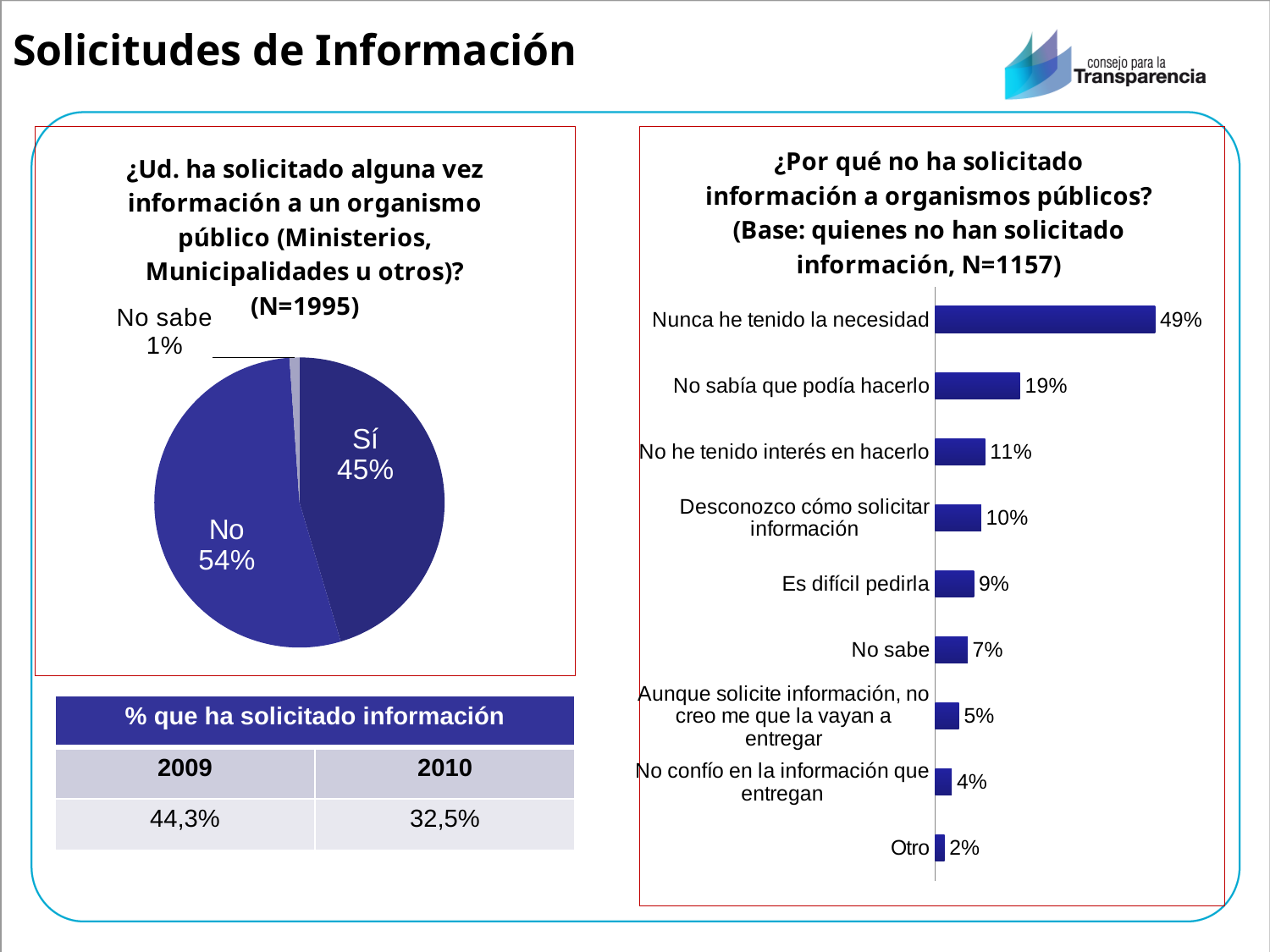
In the pie chart on the left, how many slices are there? 3 In the bar chart on the right, what is the difference between "Nunca he tenido la necesidad" and "No sabía que podía hacerlo"? 30% In the bar chart on the right, what is the value for "Es difícil pedirla"? 9% What kind of chart is the chart on the left? Pie chart In the bar chart on the right, which category has the lowest value? Otro What kind of chart is the chart on the right? Bar chart In the bar chart on the right, which is larger: "No he tenido interés en hacerlo" or "No sabe"? No he tenido interés en hacerlo In the bar chart on the right, how many categories are shown? 9 In the pie chart on the left, what percentage answered "Sí"? 45% In the pie chart on the left, which category has the smallest share? No sabe In the pie chart on the left, what percentage answered "No"? 54% In the bar chart on the right, what is the value for "Nunca he tenido la necesidad"? 49%